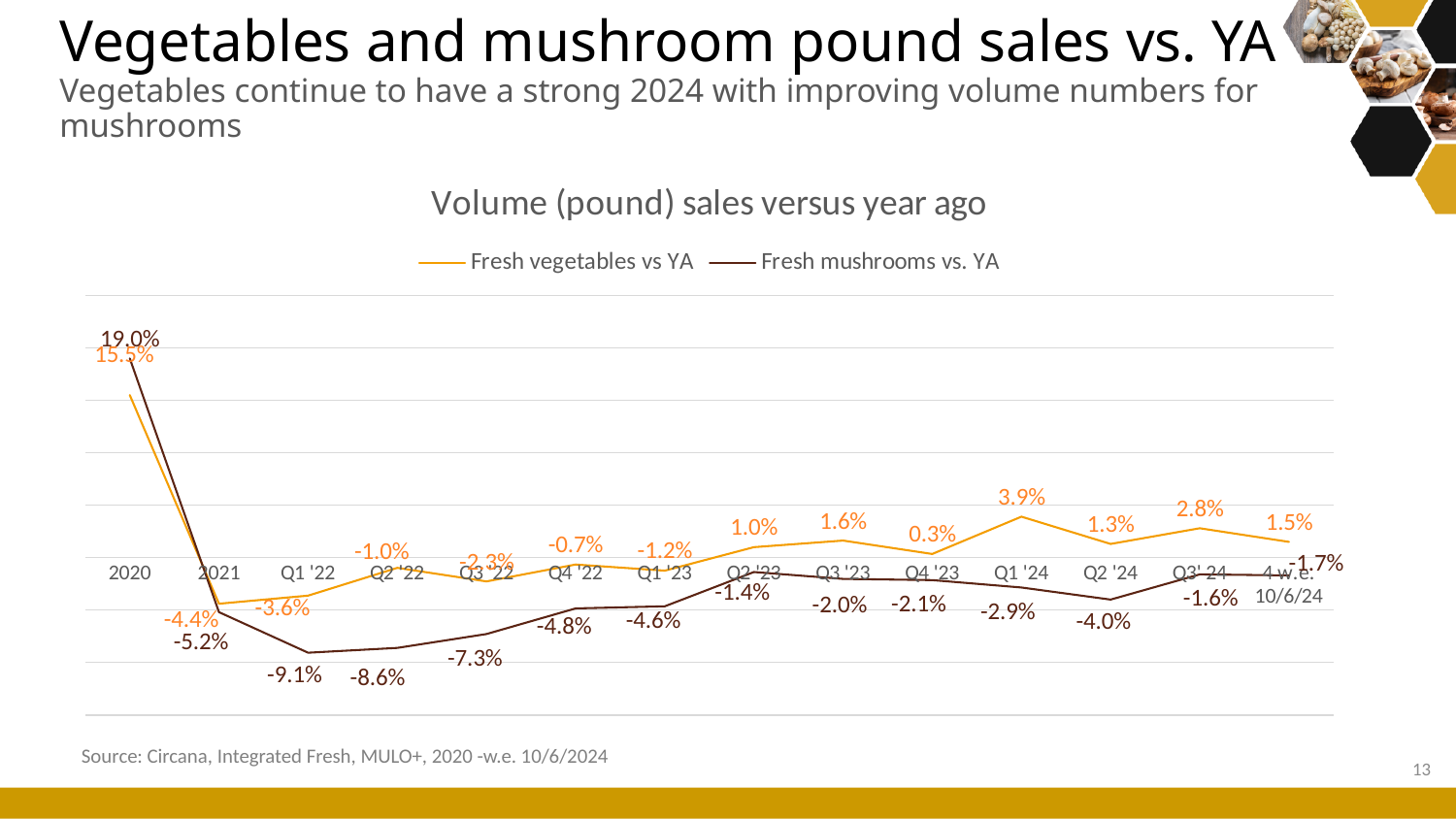
What type of chart is shown? Line chart What is the Fresh mushrooms vs. YA value for Q1 '22? -9.1% What is the Fresh mushrooms vs. YA value for 2020? 19.0% Which period has the highest Fresh vegetables vs YA value? 2020 How many periods are plotted on the x axis? 14 What is the Fresh vegetables vs YA value for Q1 '24? 3.9% Which period has the lowest Fresh mushrooms vs. YA value? Q1 '22 What is the difference between the Fresh vegetables vs YA and Fresh mushrooms vs. YA values for Q2 '24? 5.3 percentage points What is the title of the chart? Volume (pound) sales versus year ago What is the Fresh vegetables vs YA value for Q3' 24? 2.8% How many series does the legend list? 2 In Q4 '23, which series has the higher value, Fresh vegetables vs YA or Fresh mushrooms vs. YA? Fresh vegetables vs YA